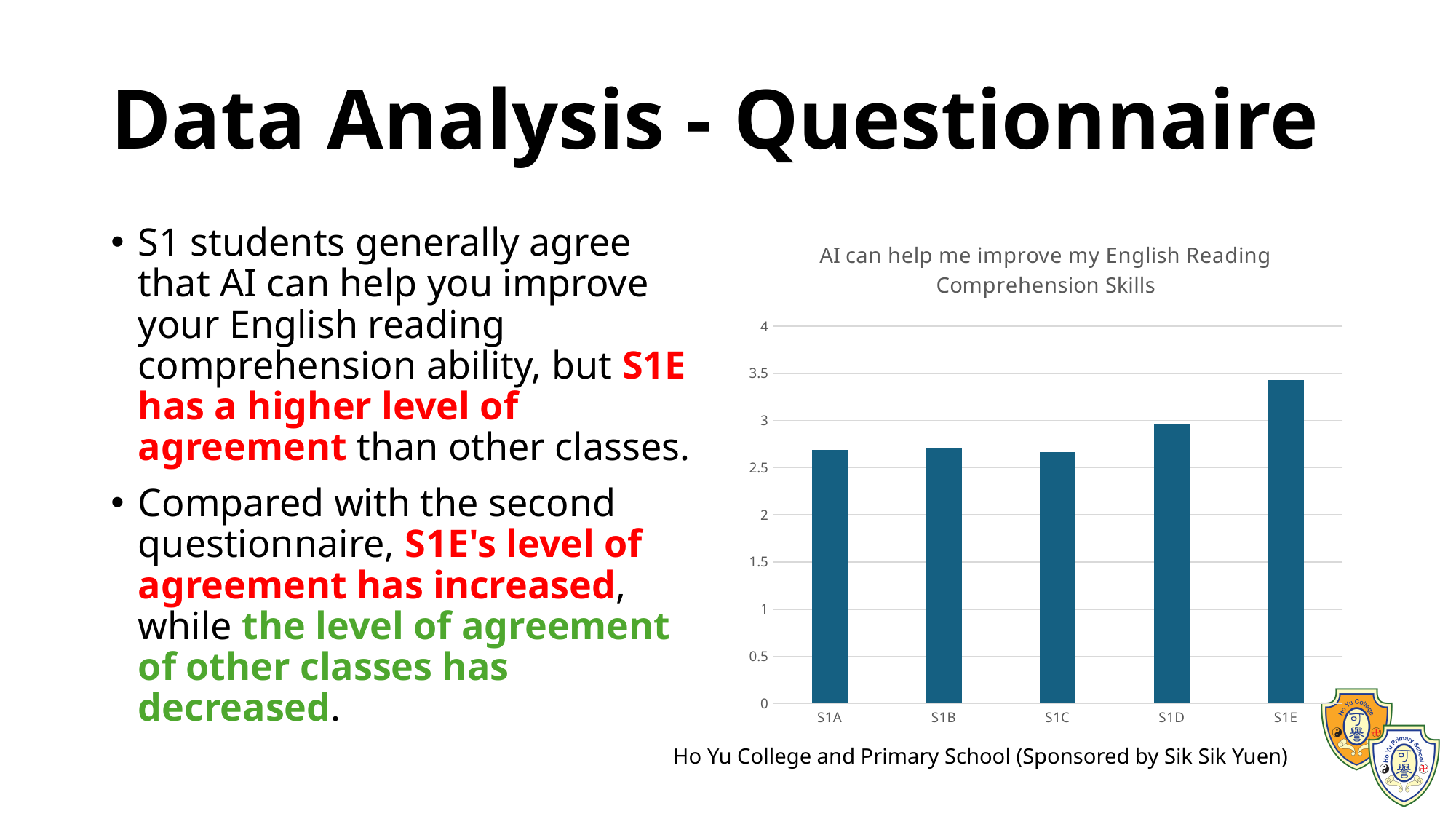
What is the highest value shown on the chart's y axis? 4 Which class has the highest value in the chart? S1E What is the title of the chart? AI can help me improve my English Reading Comprehension Skills Which has a larger value, S1E or S1D? S1E Which has a larger value, S1D or S1A? S1D Is the value for S1A greater or less than 3? less Is the value for S1C greater or less than 2.5? greater How many classes are shown on the x axis of the chart? 5 Is the value for S1D greater or less than 2.5? greater What kind of chart is shown on the slide? bar chart